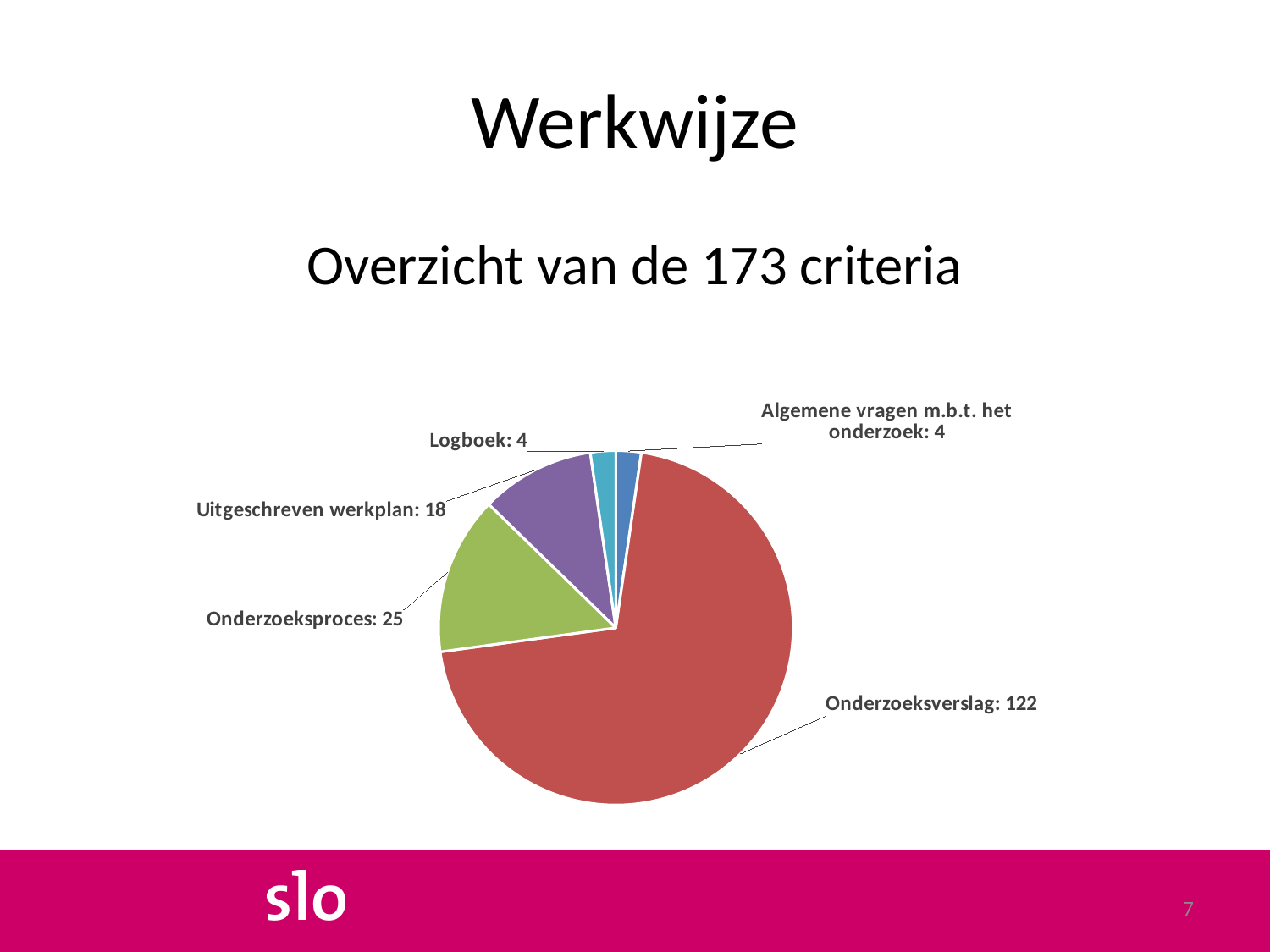
What is the difference between the values for Onderzoeksverslag and Onderzoeksproces? 97 What is the value for Algemene vragen m.b.t. het onderzoek in the pie chart? 4 Which is larger: Uitgeschreven werkplan or Onderzoeksproces? Onderzoeksproces What is the difference between the values for Onderzoeksproces and Uitgeschreven werkplan? 7 What is the value for Logboek in the pie chart? 4 What is the value for Onderzoeksproces in the pie chart? 25 What kind of chart is shown on the slide? Pie chart What is the value for Uitgeschreven werkplan in the pie chart? 18 How many slices does the pie chart have? 5 How many criteria does the pie chart show for Onderzoeksverslag? 122 Which category has the largest slice in the pie chart? Onderzoeksverslag What is the total number of criteria across all slices of the pie chart? 173